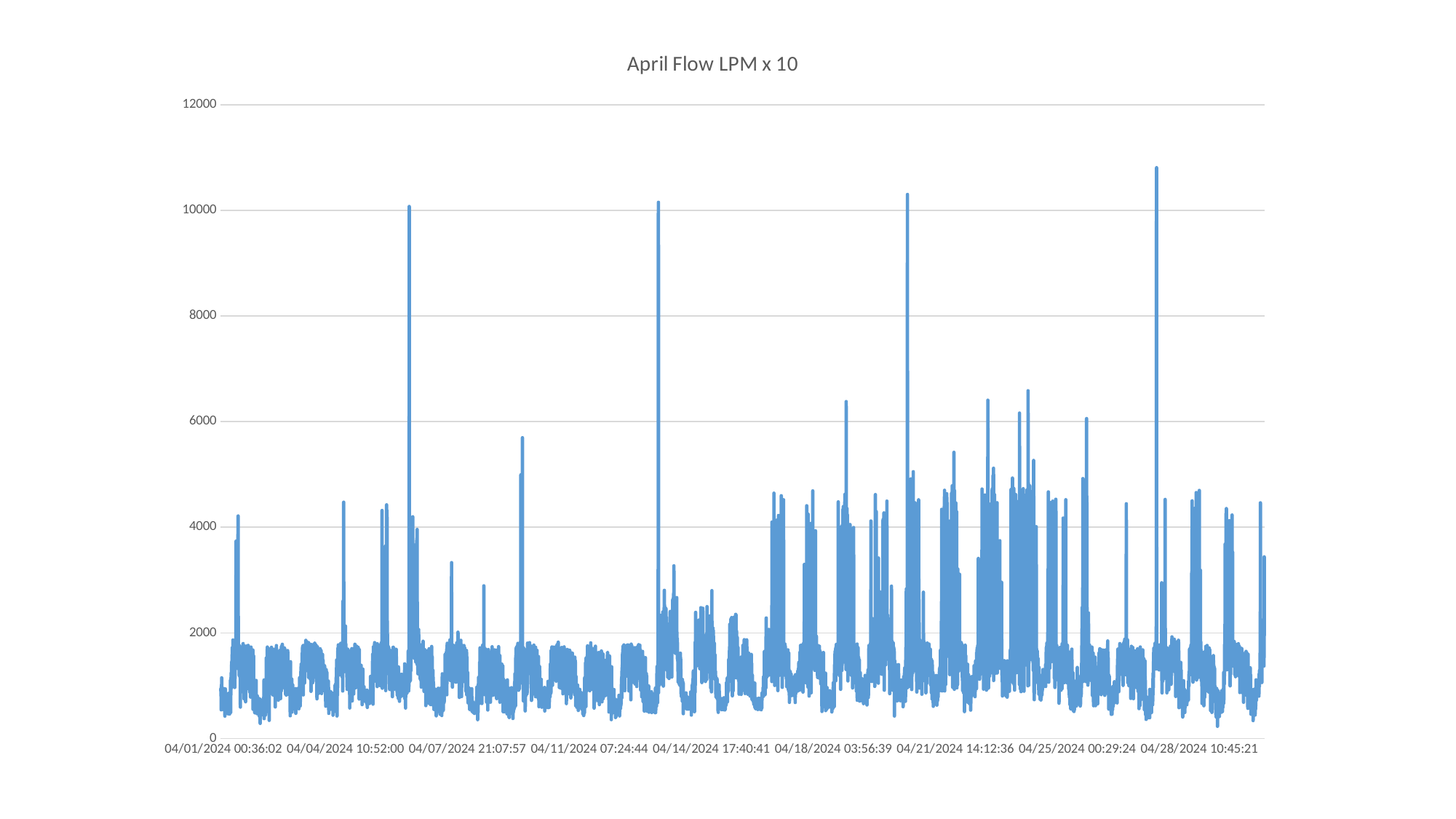
Is the highest peak in the chart greater or less than 10000? greater What is the title of the chart? April Flow LPM x 10 What kind of chart is shown on the slide? line chart How many date labels are printed along the x axis? 9 Is the spike near the 04/14/2024 17:40:41 label greater or less than 12000? less Is the highest peak in the chart greater or less than 12000? less What is the first date label on the x axis? 04/01/2024 00:36:02 Near which x-axis label does the highest peak of the series occur? 04/28/2024 10:45:21 What is the highest value shown on the vertical axis of the chart? 12000